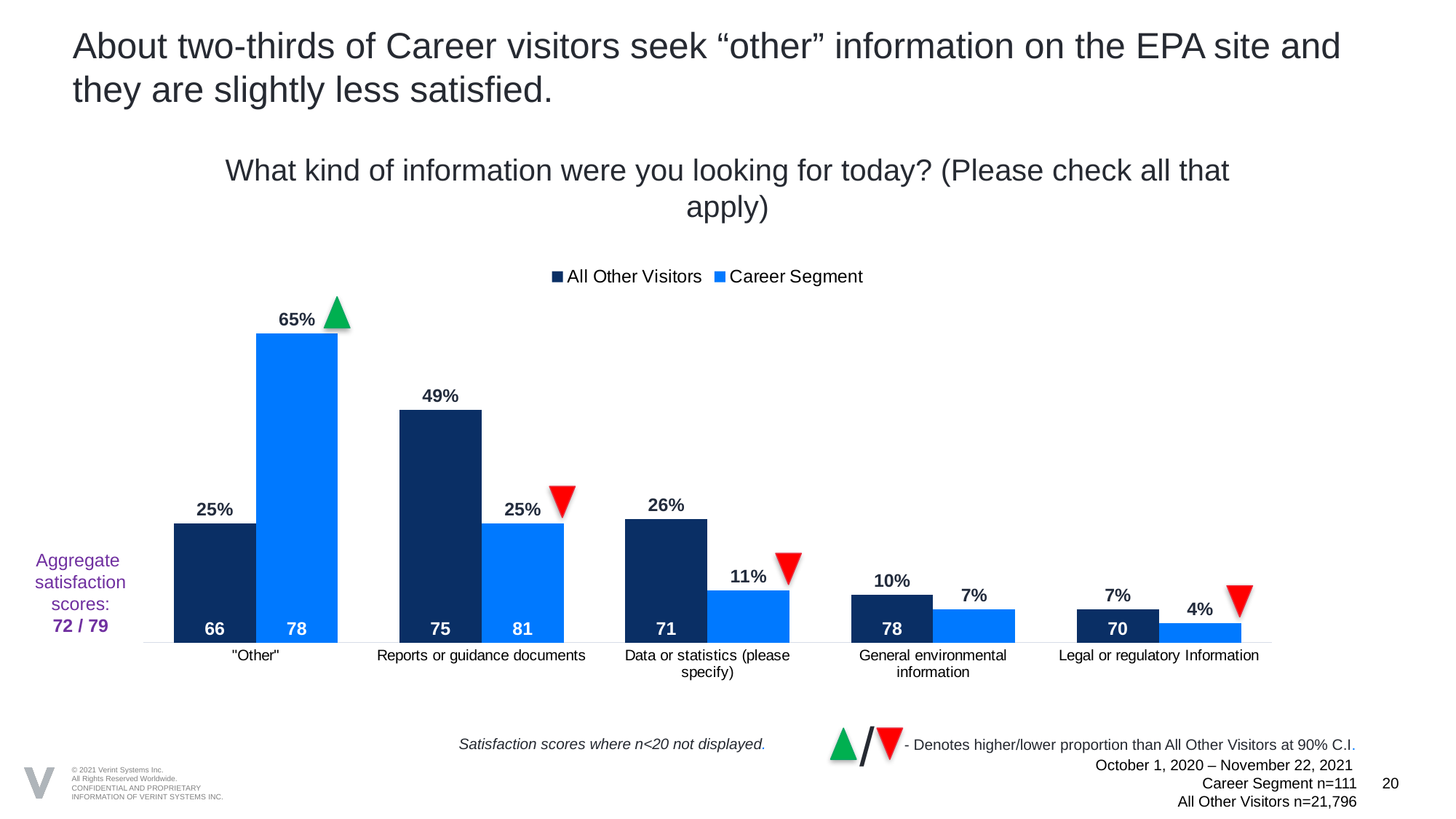
Which category has the lowest value for the Career Segment? Legal or regulatory Information What is the title of the chart? What kind of information were you looking for today? (Please check all that apply) How many categories are shown on the x axis? 5 What kind of chart is shown on the slide? Bar chart How many series does the legend list? 2 What is the aggregate satisfaction score shown inside the Career Segment bar for Reports or guidance documents? 81 For General environmental information, which series has the larger value: All Other Visitors or Career Segment? All Other Visitors What is the difference between the Career Segment and All Other Visitors values for "Other"? 40 percentage points What percentage of All Other Visitors were looking for Reports or guidance documents? 49% What percentage of the Career Segment were looking for "Other" information? 65% What is the Career Segment value for Data or statistics (please specify)? 11% Which category has the highest value for All Other Visitors? Reports or guidance documents